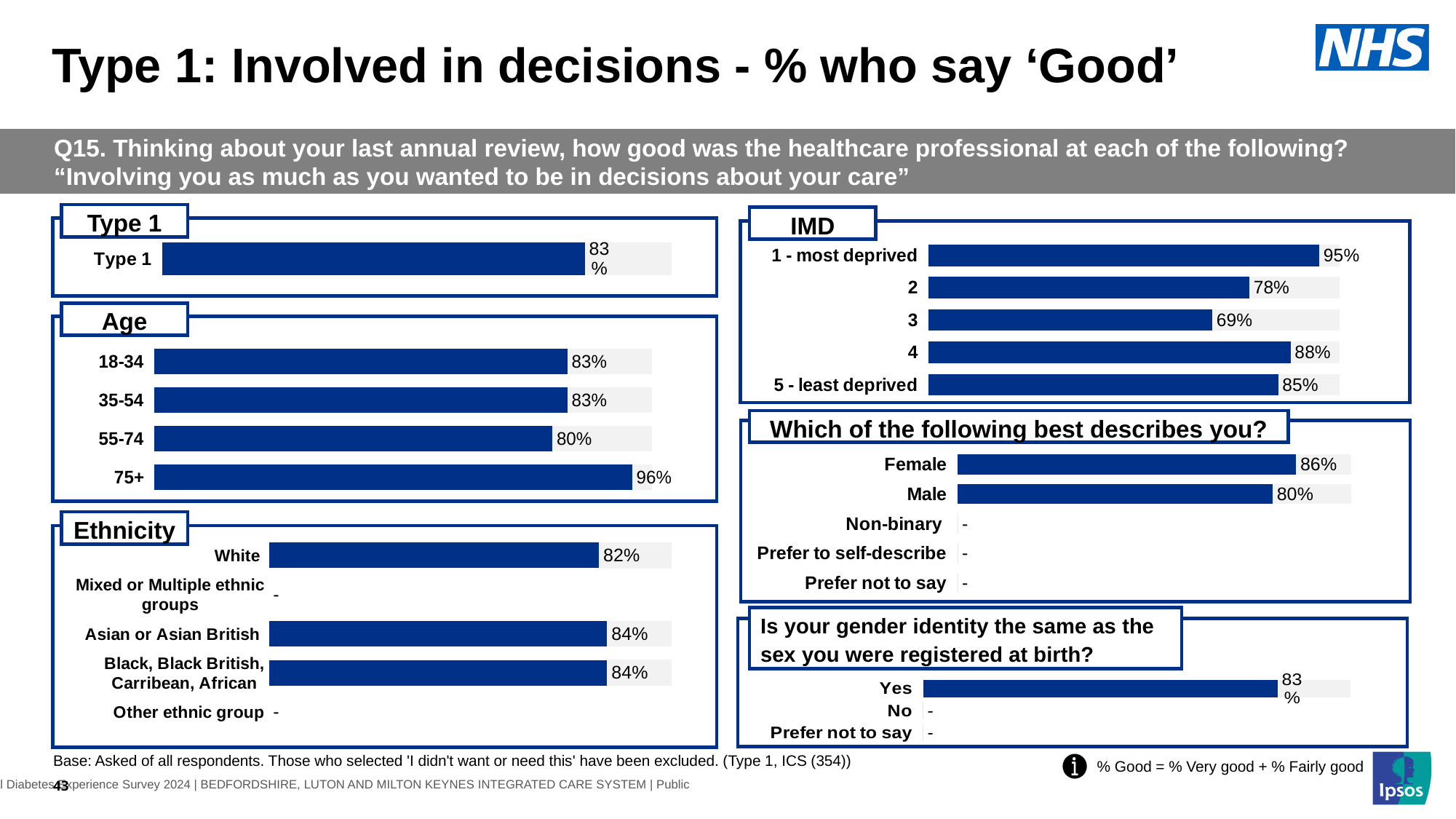
In the IMD chart, which category has the lowest value? 3 In the Ethnicity chart, what is the value for White? 82% In the 'Which of the following best describes you?' chart, what is the value for Female? 86% In the Ethnicity chart, which is larger, the value for White or the value for Asian or Asian British? Asian or Asian British In the Age chart, what is the value for 55-74? 80% In the IMD chart, what is the value for 1 - most deprived? 95% In the Type 1 chart, what is the value for Type 1? 83% In the 'Is your gender identity the same as the sex you were registered at birth?' chart, what is the value for Yes? 83% In the Age chart, what is the difference between the values for 75+ and 55-74? 16 percentage points In the IMD chart, what is the difference between the values for 1 - most deprived and 2? 17 percentage points How many categories are shown in the IMD chart? 5 In the Age chart, which age group has the highest value? 75+